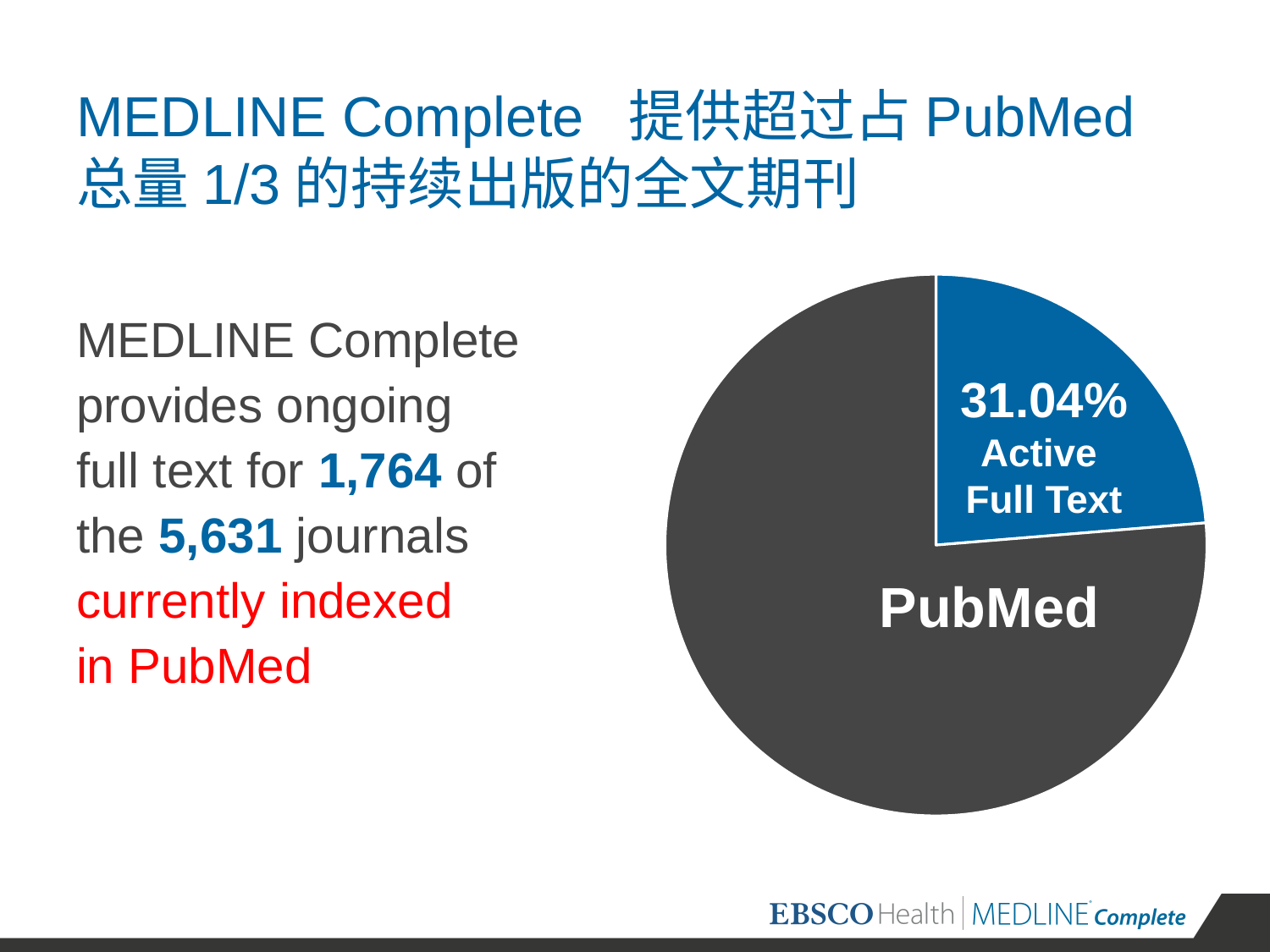
Which slice of the pie chart is larger, PubMed or Active Full Text? PubMed What share of the pie is labelled Active Full Text? 31.04% What colour is the Active Full Text slice of the pie chart? blue What is the label on the dark grey slice of the pie chart? PubMed Which slice of the pie chart is the smallest? Active Full Text What kind of chart is shown on the slide? pie chart Which slice of the pie chart is the largest? PubMed What percentage is printed on the blue slice of the pie chart? 31.04% How many slices does the pie chart have? 2